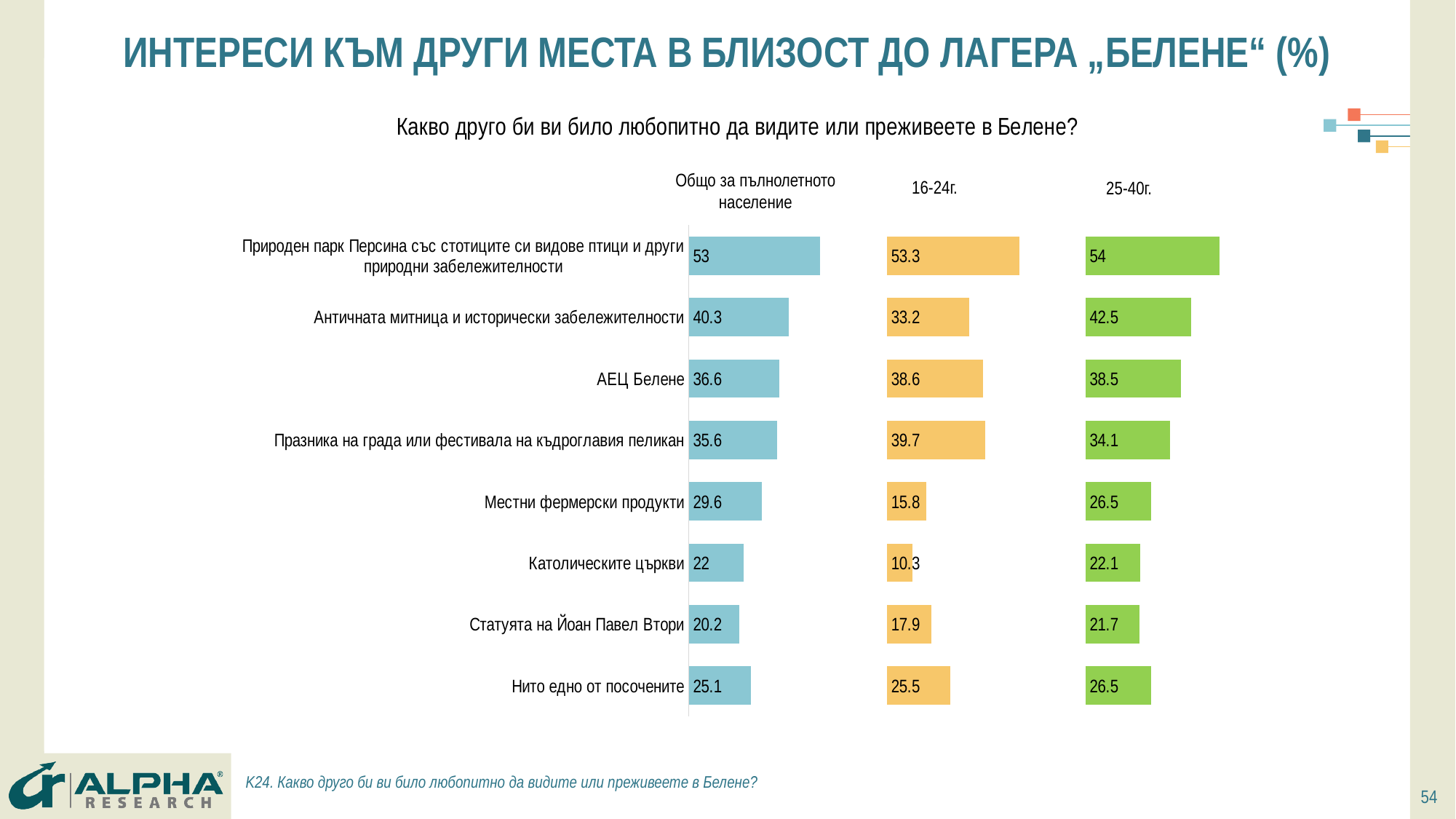
In the "16-24г." chart, which is larger: "АЕЦ Белене" or "Празника на града или фестивала на къдроглавия пеликан"? Празника на града или фестивала на къдроглавия пеликан In the "Общо за пълнолетното население" chart, what is the value for "АЕЦ Белене"? 36.6 Is the value for "Католическите църкви" in the "16-24г." chart greater or less than 20? less What kind of chart is used on this slide? Bar chart In the "16-24г." chart, what is the value for "Местни фермерски продукти"? 15.8 What is the difference between the "25-40г." and "16-24г." values for "Местни фермерски продукти"? 10.7 In the "Общо за пълнолетното население" chart, what is the difference between "Античната митница и исторически забележителности" and "Католическите църкви"? 18.3 In the "25-40г." chart, which category has the highest value? Природен парк Персина със стотиците си видове птици и други природни забележителности In the "16-24г." chart, which category has the lowest value? Католическите църкви In the "25-40г." chart, what is the value for "Статуята на Йоан Павел Втори"? 21.7 How many categories are shown in the "Общо за пълнолетното население" chart? 8 What colour are the bars in the "25-40г." chart? Green